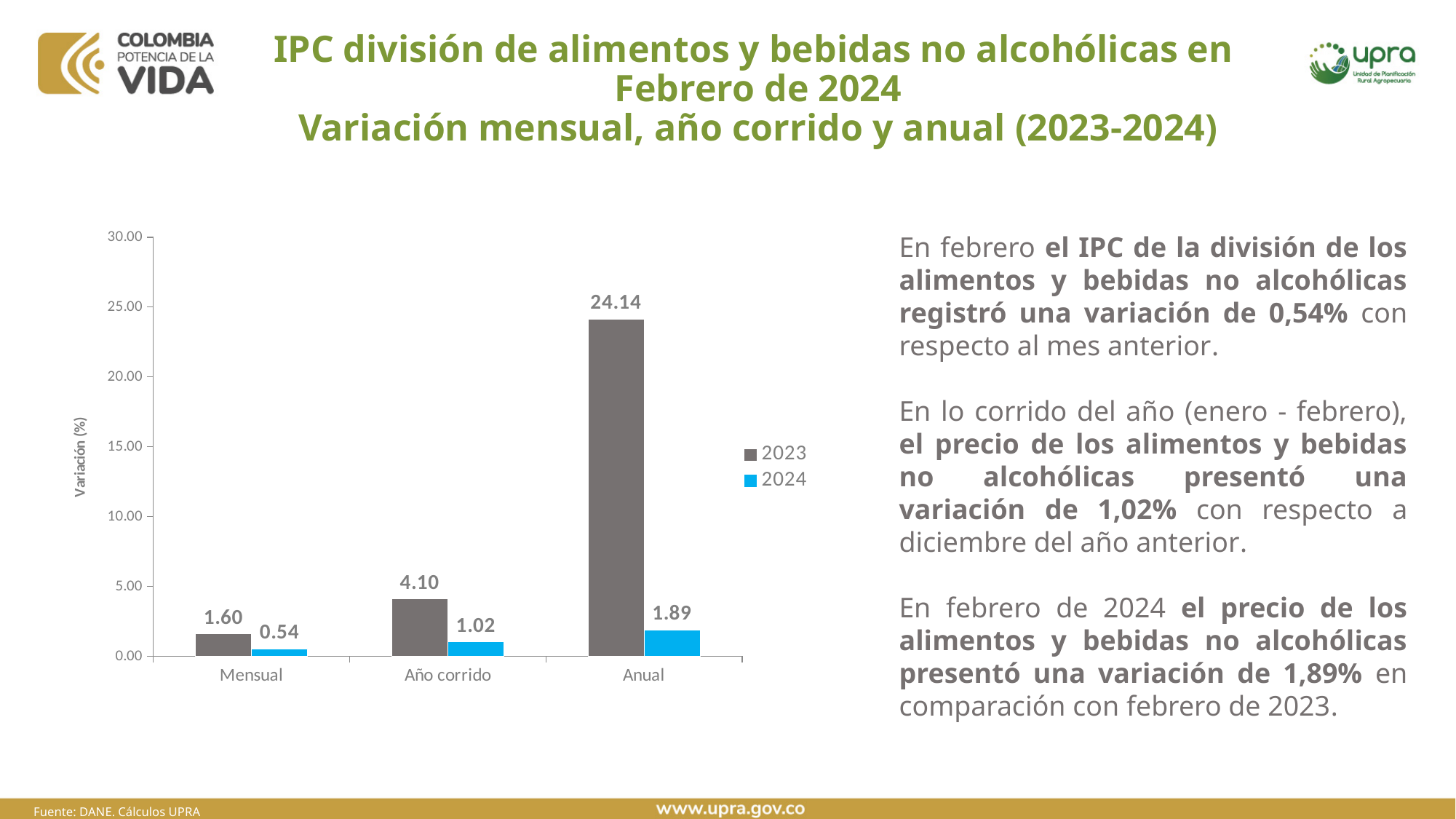
What is the difference between the 2023 and 2024 values in the Anual category? 22.25 How many series does the legend list? 2 What is the value for 2023 in the Mensual category? 1.60 What is the value for 2024 in the Año corrido category? 1.02 Is the 2023 value for Anual greater or less than 20.00? greater What kind of chart is shown on the slide? bar chart Which is larger in the Año corrido category, the 2023 value or the 2024 value? 2023 Which category has the highest value for the 2023 series? Anual Which category has the lowest value for the 2024 series? Mensual How many categories are shown on the x axis? 3 What is the value for 2024 in the Anual category? 1.89 What is the value for 2023 in the Anual category? 24.14